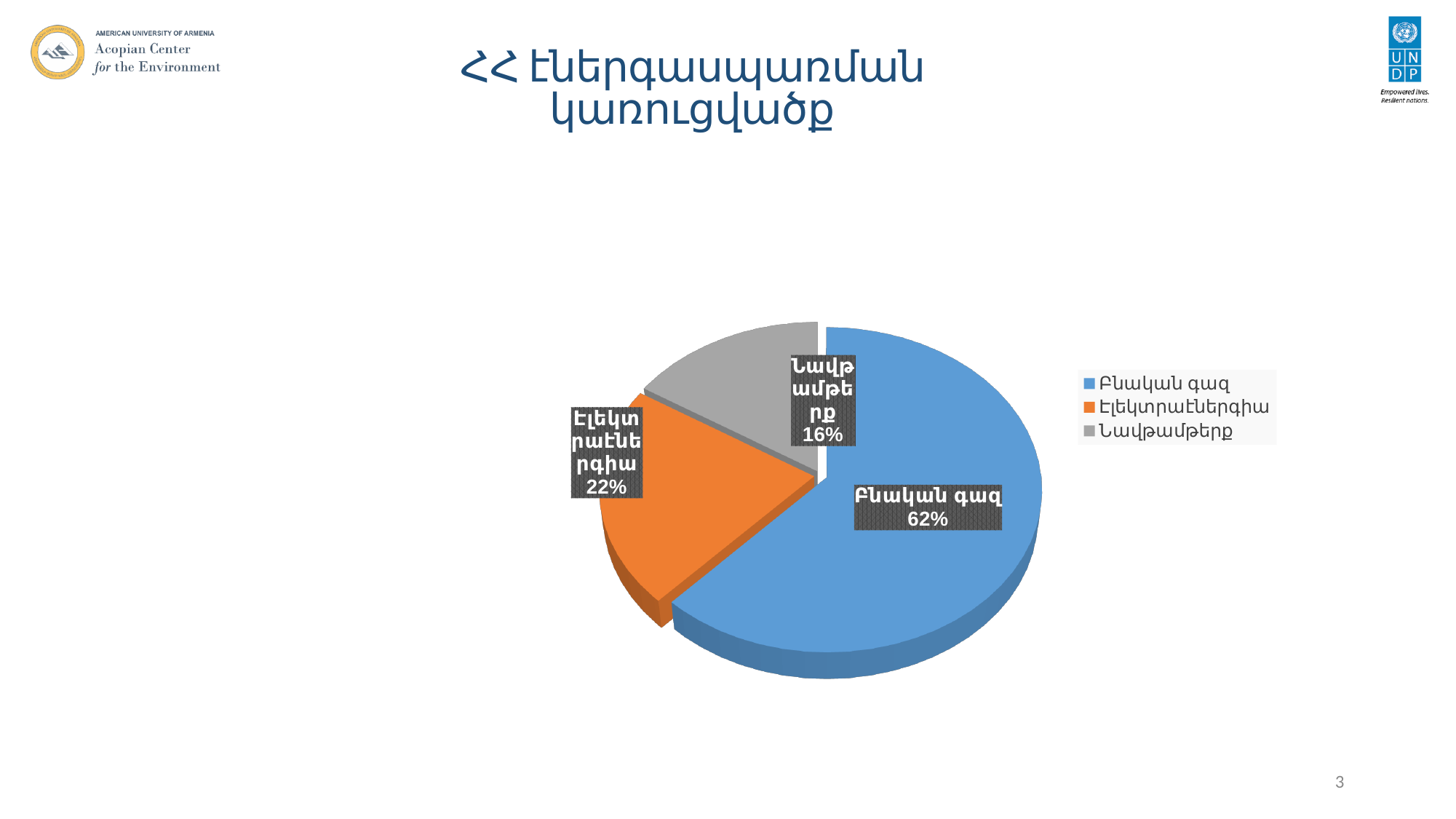
What share of the pie does Նավթամթերք represent? 16% What is the difference in percentage points between the Բնական գազ slice and the Էլեկտրաէներգիա slice? 40 Which category has the largest slice of the pie? Բնական գազ What colour is the Էլեկտրաէներգիա slice in the pie chart? Orange What kind of chart is shown on the slide? Pie chart What is the difference in percentage points between the Էլեկտրաէներգիա slice and the Նավթամթերք slice? 6 What share of the pie does Էլեկտրաէներգիա represent? 22% What share of the pie does Բնական գազ represent? 62% What is the title of the slide containing the chart? ՀՀ Էներգասպառման կառուցվածք Which slice is larger, Էլեկտրաէներգիա or Նավթամթերք? Էլեկտրաէներգիա How many slices does the pie chart have? 3 Which category has the smallest slice of the pie? Նավթամթերք